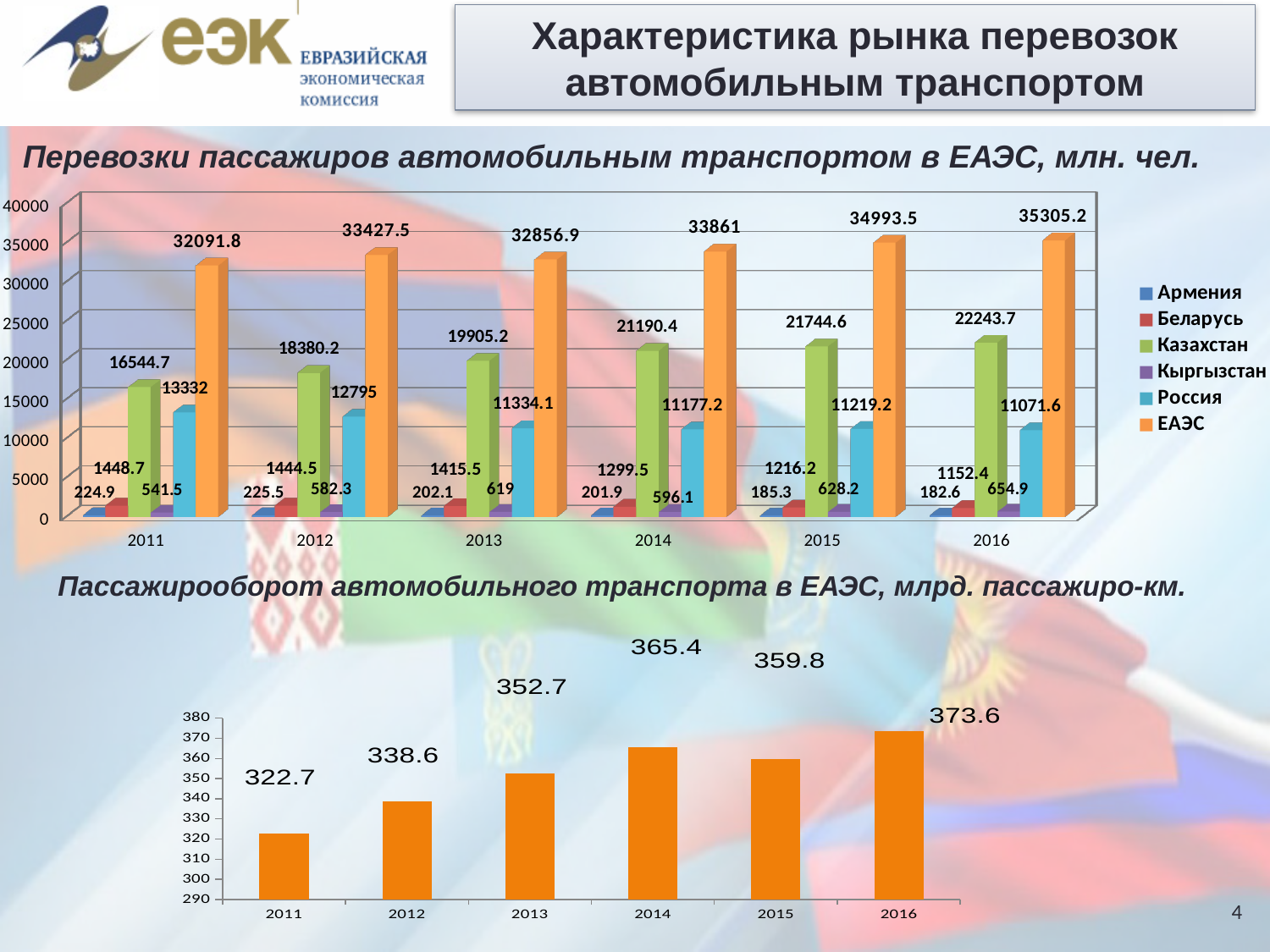
In the bottom chart, what is the difference between the values for 2016 and 2015? 13.8 In the top chart, which year has the highest value for ЕАЭС? 2016 In the top chart, what is the difference between the ЕАЭС values for 2016 and 2011? 3213.4 In the bottom chart (Пассажирооборот автомобильного транспорта в ЕАЭС), what is the value for 2014? 365.4 In the top chart, how many series does the legend list? 6 In the top chart, which is larger in 2014: the value for Казахстан or the value for Россия? Казахстан In the top chart, what is the value for Казахстан in 2013? 19905.2 In the bottom chart, which year has the lowest value? 2011 In the top chart (Перевозки пассажиров автомобильным транспортом в ЕАЭС), what is the value for ЕАЭС in 2016? 35305.2 In the top chart, does the value for Россия rise or fall from 2011 to 2016? fall What kind of chart is the bottom chart? bar chart In the top chart, what is the value for Россия in 2011? 13332